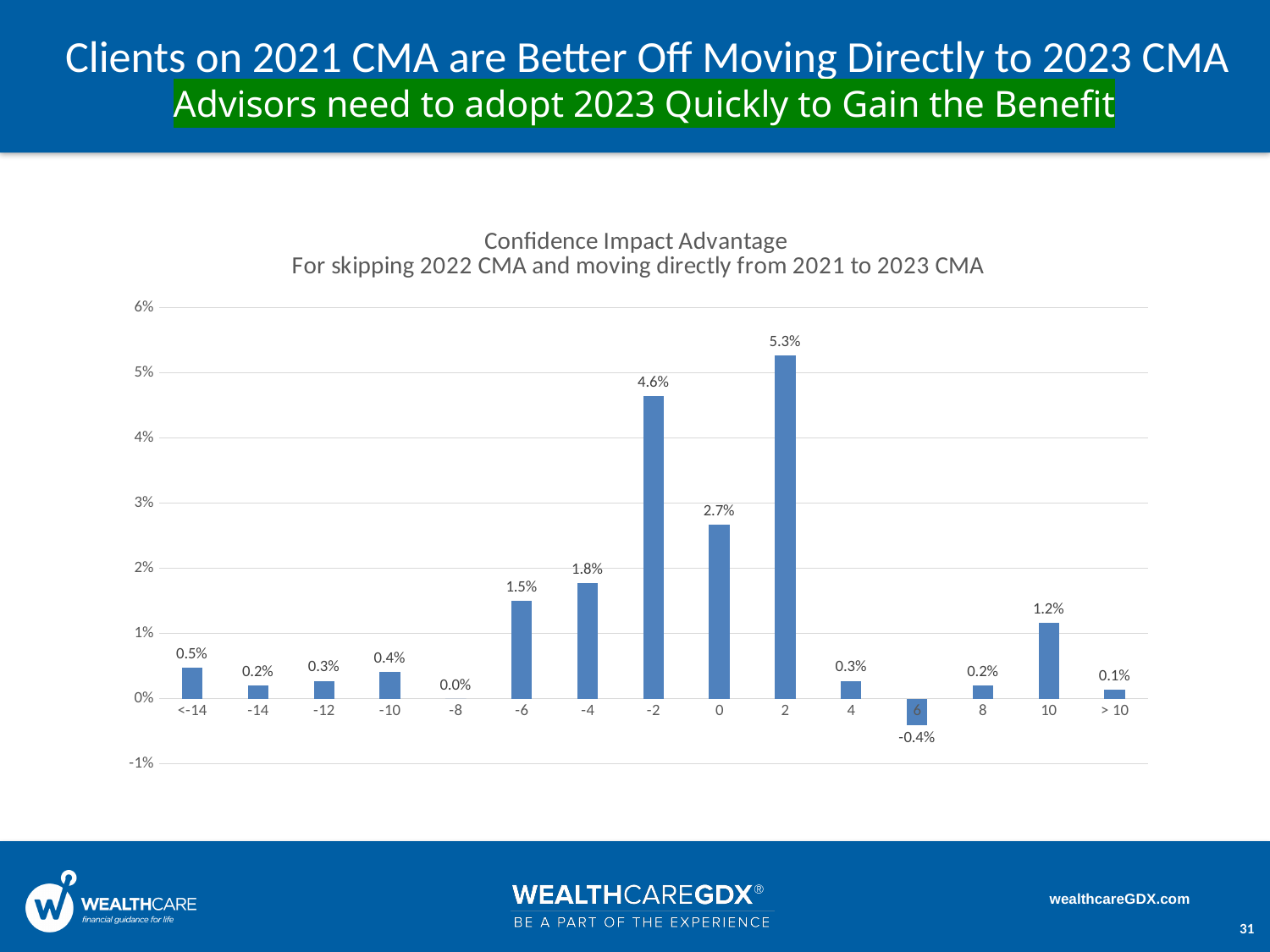
Which category has the lowest value? 6 Which category has the highest value? 2 Is the value for category -6 greater or less than 1%? greater What is the value for category 2? 5.3% What is the title of the chart? Confidence Impact Advantage For skipping 2022 CMA and moving directly from 2021 to 2023 CMA What is the difference between the values for category 2 and category -2? 0.7% What kind of chart is shown on the slide? bar chart What is the value for category 10? 1.2% Which is larger, the value for category 0 or the value for category -4? 0 How many categories are shown on the x axis? 15 What is the value for category -2? 4.6% What is the value for category 6? -0.4%